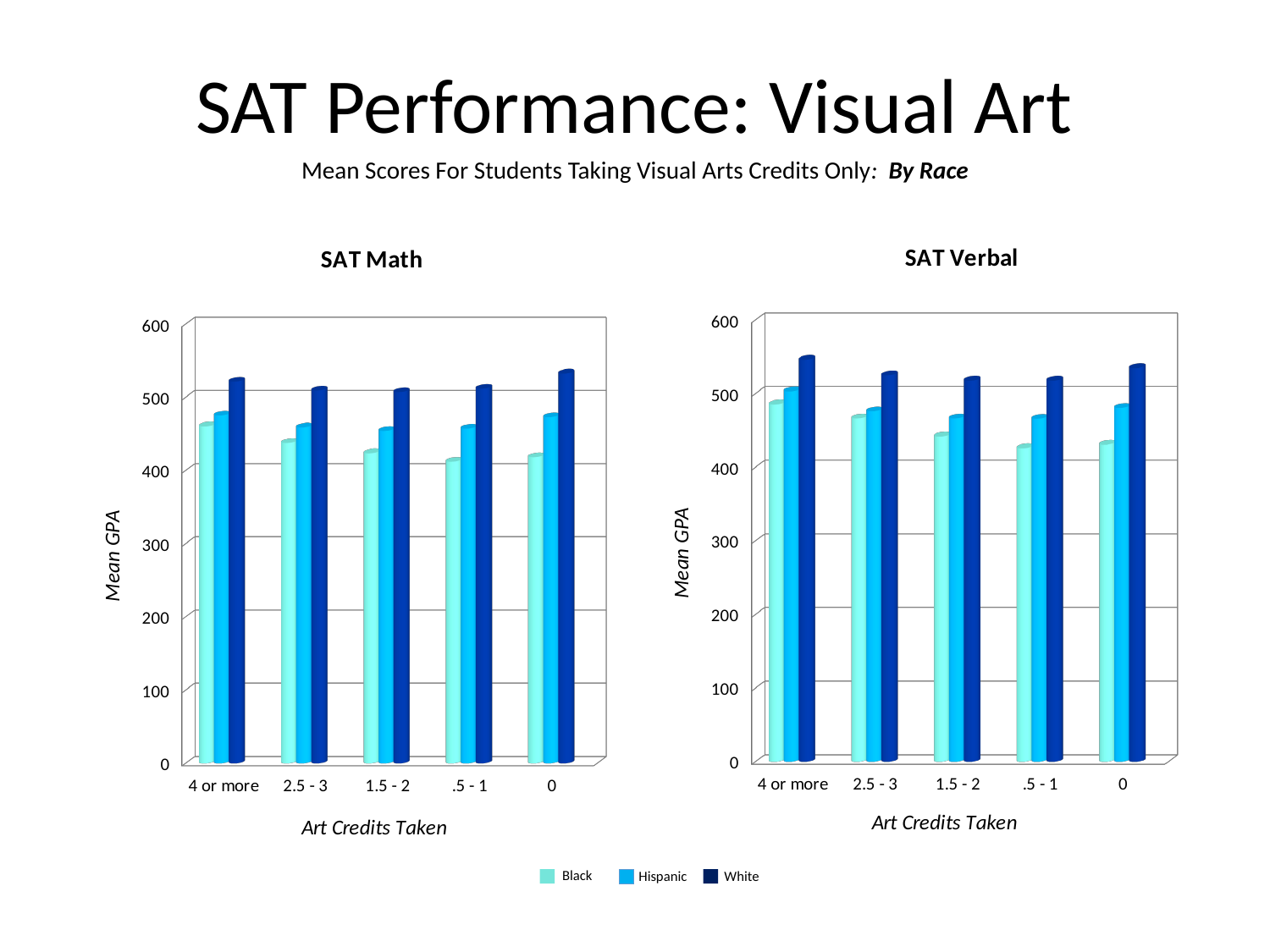
In the SAT Verbal chart, is the value for Black at .5 - 1 art credits greater or less than 500? less What kind of chart is the SAT Math chart? bar chart How many series does the legend list? 3 How many categories are shown on the x axis of the SAT Verbal chart? 5 In the SAT Math chart, is the value for Hispanic at 4 or more art credits greater or less than 500? less In the SAT Math chart, is the value for White at 0 art credits greater or less than 500? greater What is the y-axis title of the SAT Math chart? Mean GPA In the SAT Math chart, which series has the highest bar in every category? White In the SAT Verbal chart, which is larger at 0 art credits, the White value or the Black value? White What is the x-axis title of the SAT Verbal chart? Art Credits Taken